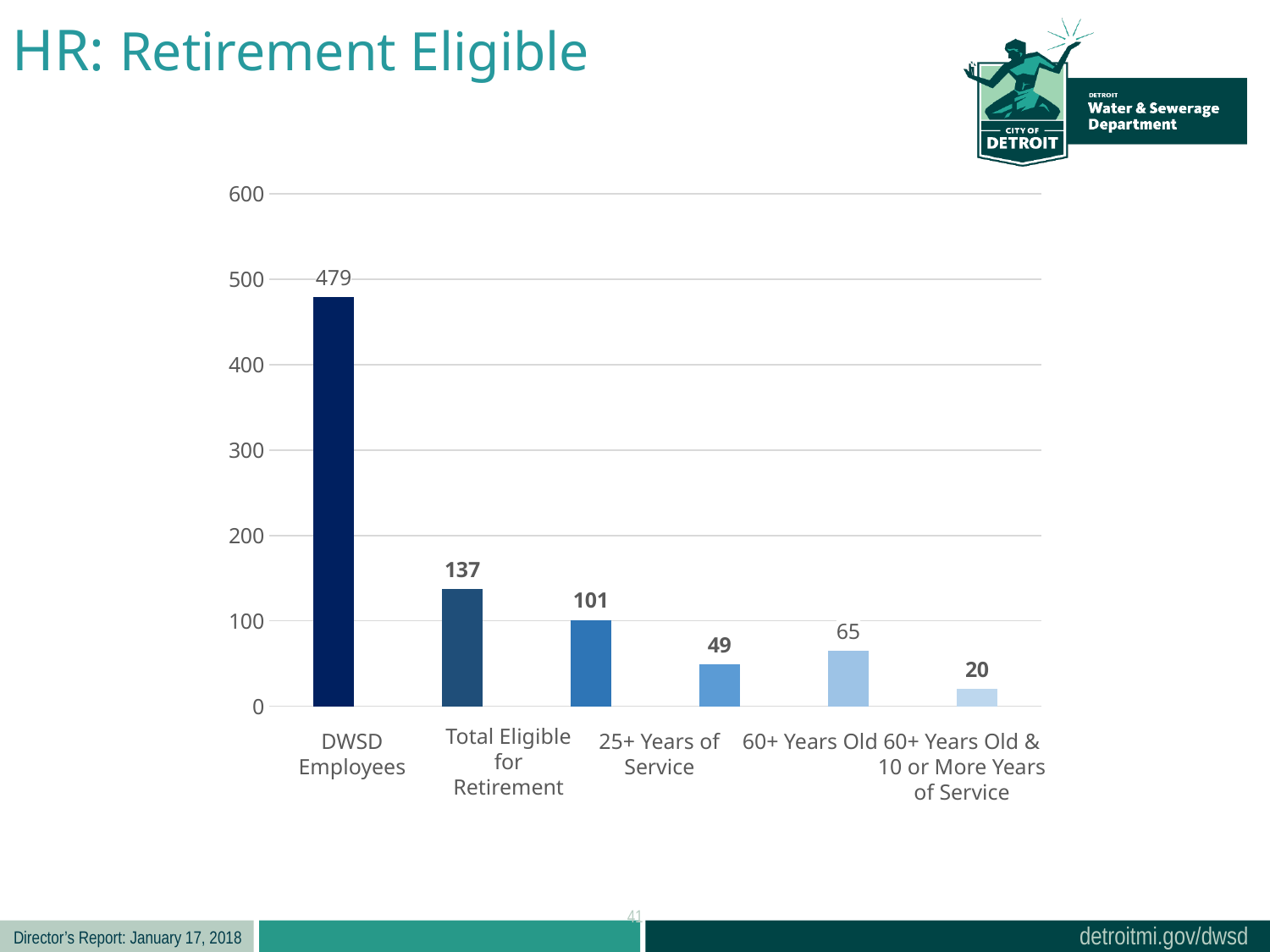
What is the value for DWSD Employees? 479 What is the difference between DWSD Employees and Total Eligible for Retirement? 342 What is the value for Total Eligible for Retirement? 137 What is the value for 60+ Years Old? 65 Which category has the highest value? DWSD Employees What type of chart is shown on the slide? Bar chart What is the value for 60+ Years Old & 10 or More Years of Service? 20 What is the value for 25+ Years of Service? 101 How many bars are plotted in the chart? 6 Which category has the lowest value? 60+ Years Old & 10 or More Years of Service What is the difference between 25+ Years of Service and 60+ Years Old? 36 Which is larger, Total Eligible for Retirement or 25+ Years of Service? Total Eligible for Retirement